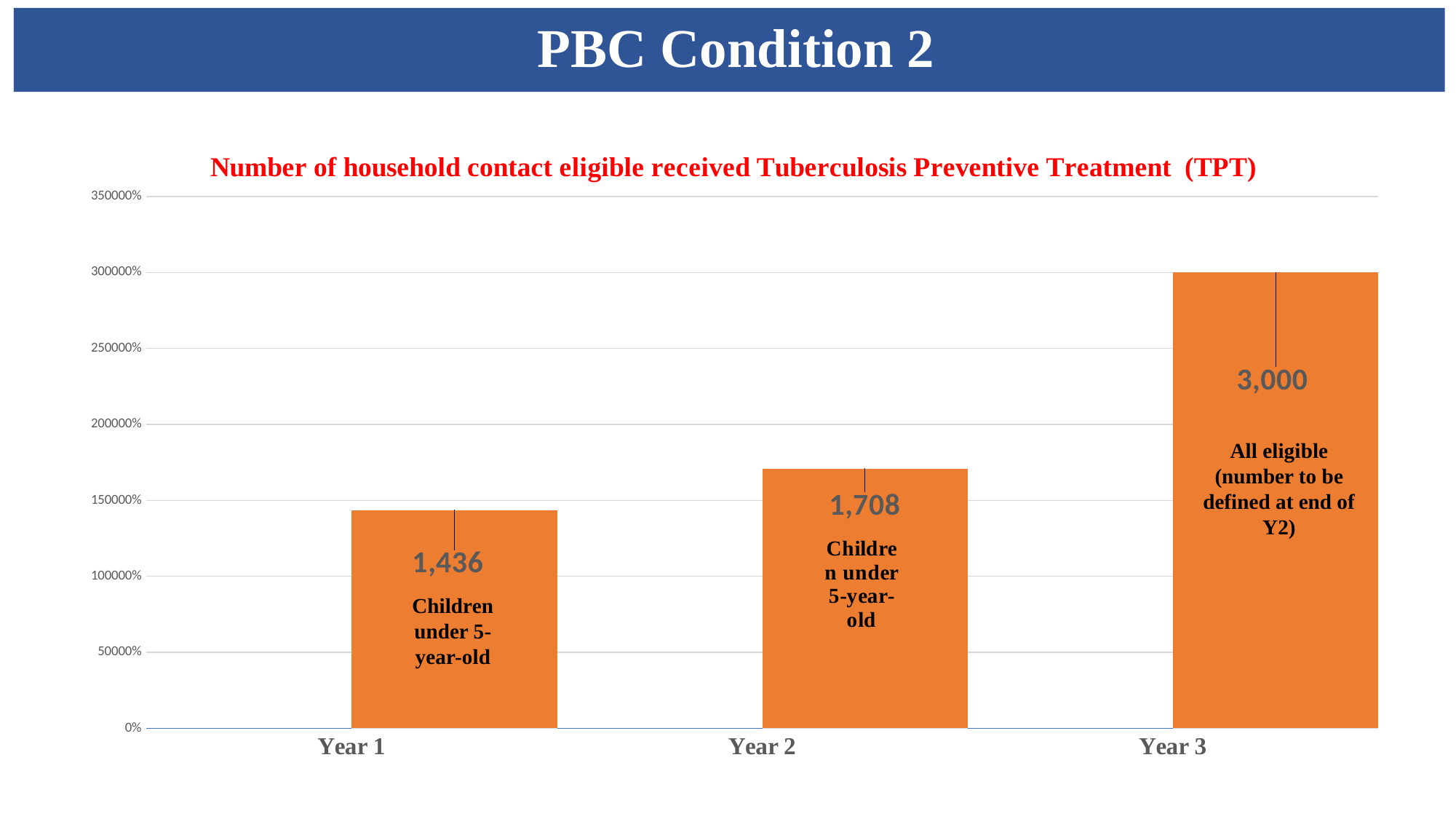
What is the difference between the values for Year 3 and Year 2? 1,292 Which year has the lowest value? Year 1 What is the value shown for Year 1? 1,436 How many years (categories) are shown on the x axis? 3 Which year has the highest value? Year 3 What is the value shown for Year 3? 3,000 What kind of chart is shown on the slide? Bar chart Which is larger, the value for Year 1 or the value for Year 2? Year 2 What is the value shown for Year 2? 1,708 What is the difference between the values for Year 2 and Year 1? 272 What is the title of the chart? Number of household contact eligible received Tuberculosis Preventive Treatment (TPT) Do the values rise or fall from Year 1 to Year 3? Rise